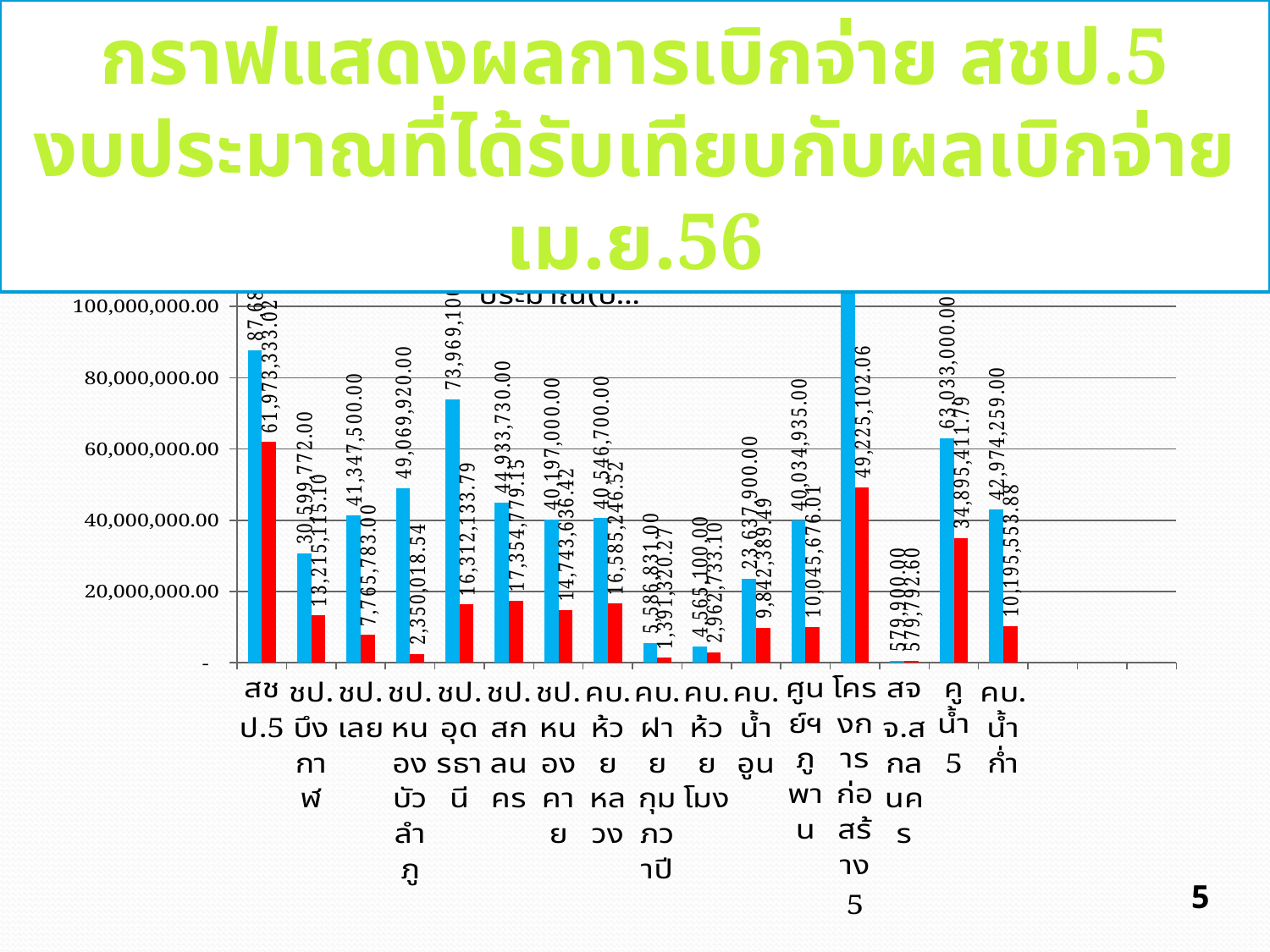
What is the value of the red bar for สชป.5? 61,973,333.02 How many categories are shown along the x axis of the chart? 16 What is the value of the red bar for คูน้ำ 5? 34,895,411.79 What kind of chart is shown on the slide? Bar chart Which has the larger blue bar: ชป.หนองบัวลำภู or ชป.สกลนคร? ชป.หนองบัวลำภู What is the value of the red bar for คบ.ฝายกุมภวาปี? 1,391,320.27 What is the value of the blue bar for ชป.เลย? 41,347,500.00 Which category has the lowest blue bar? สจจ.สกลนคร How many data series (bar colours) does the chart plot? 2 What is the difference between the blue bar and the red bar for ชป.สกลนคร? 27,578,950.85 Which category has the highest red bar? สชป.5 Is the blue bar for โครงการก่อสร้าง 5 greater or less than 100,000,000.00? greater